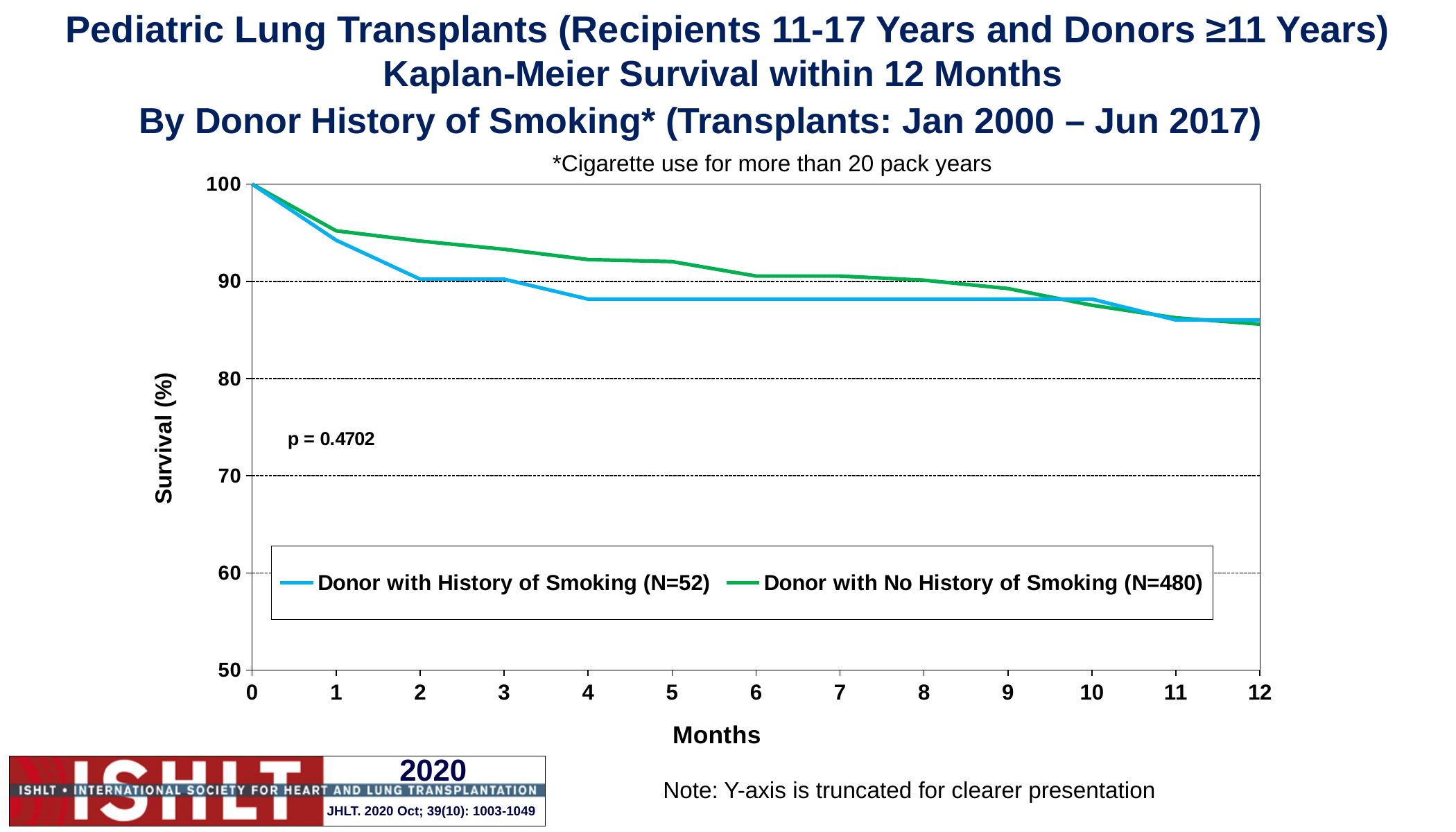
What kind of chart is shown on the slide? line chart Is the survival value for Donor with History of Smoking at month 4 greater or less than 90? less What is the N for the Donor with No History of Smoking series in the legend? N=480 How many month ticks are labelled on the x axis? 13 What p-value is printed on the chart? p = 0.4702 Is the survival value for Donor with No History of Smoking at month 12 greater or less than 90? less Is the survival value for Donor with No History of Smoking at month 2 greater or less than 90? greater How many series does the legend list? 2 What is the survival value for Donor with History of Smoking at month 0? 100 Do the survival values for Donor with No History of Smoking rise or fall from month 0 to month 12? fall At month 4, which series has the higher survival: Donor with History of Smoking or Donor with No History of Smoking? Donor with No History of Smoking